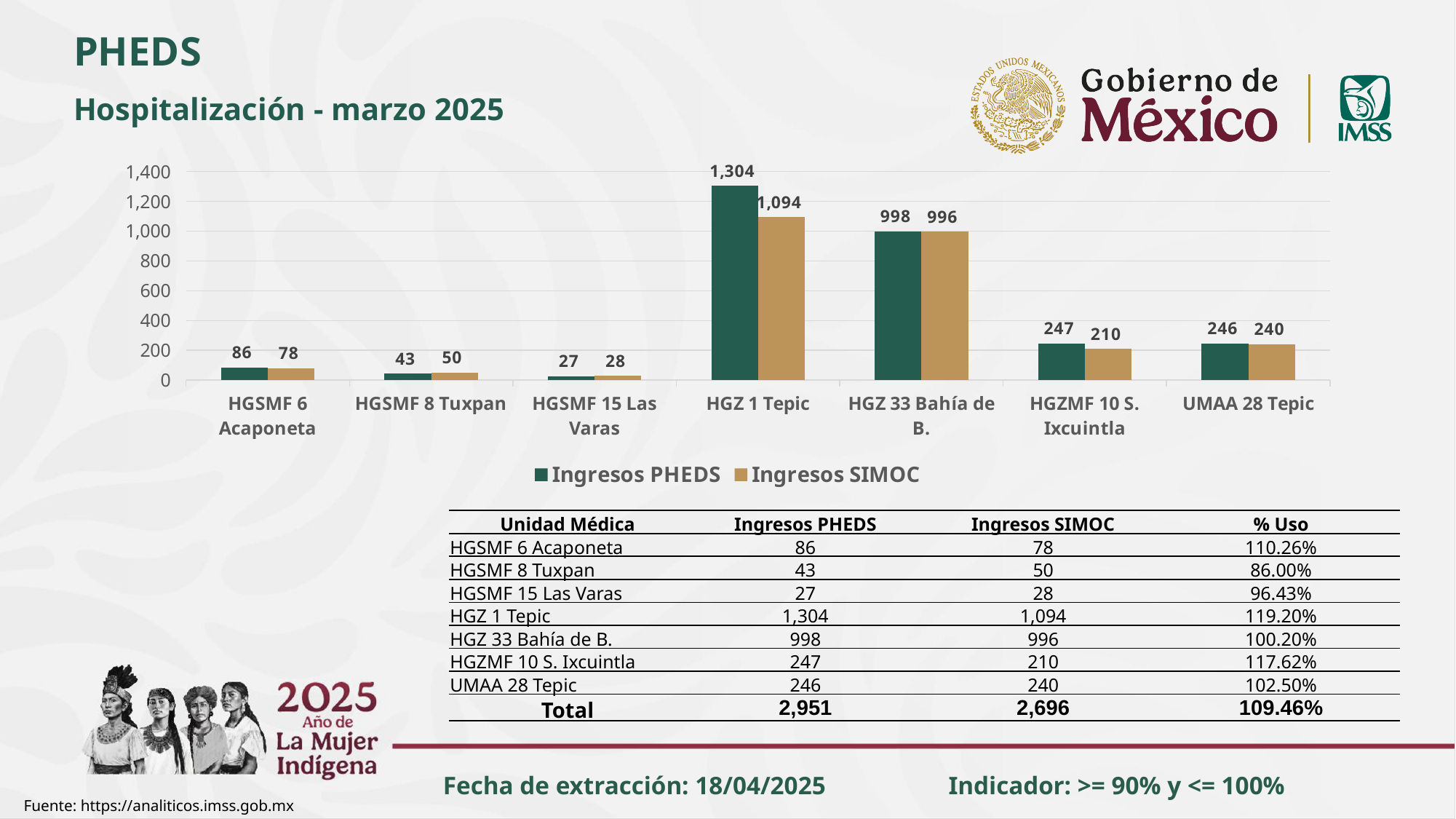
What is the Ingresos SIMOC value for HGZMF 10 S. Ixcuintla? 210 How many series does the chart legend list? 2 What kind of chart is shown on the slide? Bar chart Which is larger for HGSMF 8 Tuxpan: Ingresos PHEDS or Ingresos SIMOC? Ingresos SIMOC What is the difference between Ingresos PHEDS and Ingresos SIMOC for HGZMF 10 S. Ixcuintla? 37 Which unit has the lowest Ingresos SIMOC value? HGSMF 15 Las Varas What is the Ingresos SIMOC value for HGSMF 8 Tuxpan? 50 What is the difference between Ingresos PHEDS and Ingresos SIMOC for HGZ 1 Tepic? 210 Which unit has the highest Ingresos PHEDS value? HGZ 1 Tepic How many medical units are shown on the x axis of the chart? 7 Is the Ingresos PHEDS value for HGZ 33 Bahía de B. greater or less than 800? greater What is the Ingresos PHEDS value for HGZ 1 Tepic? 1,304